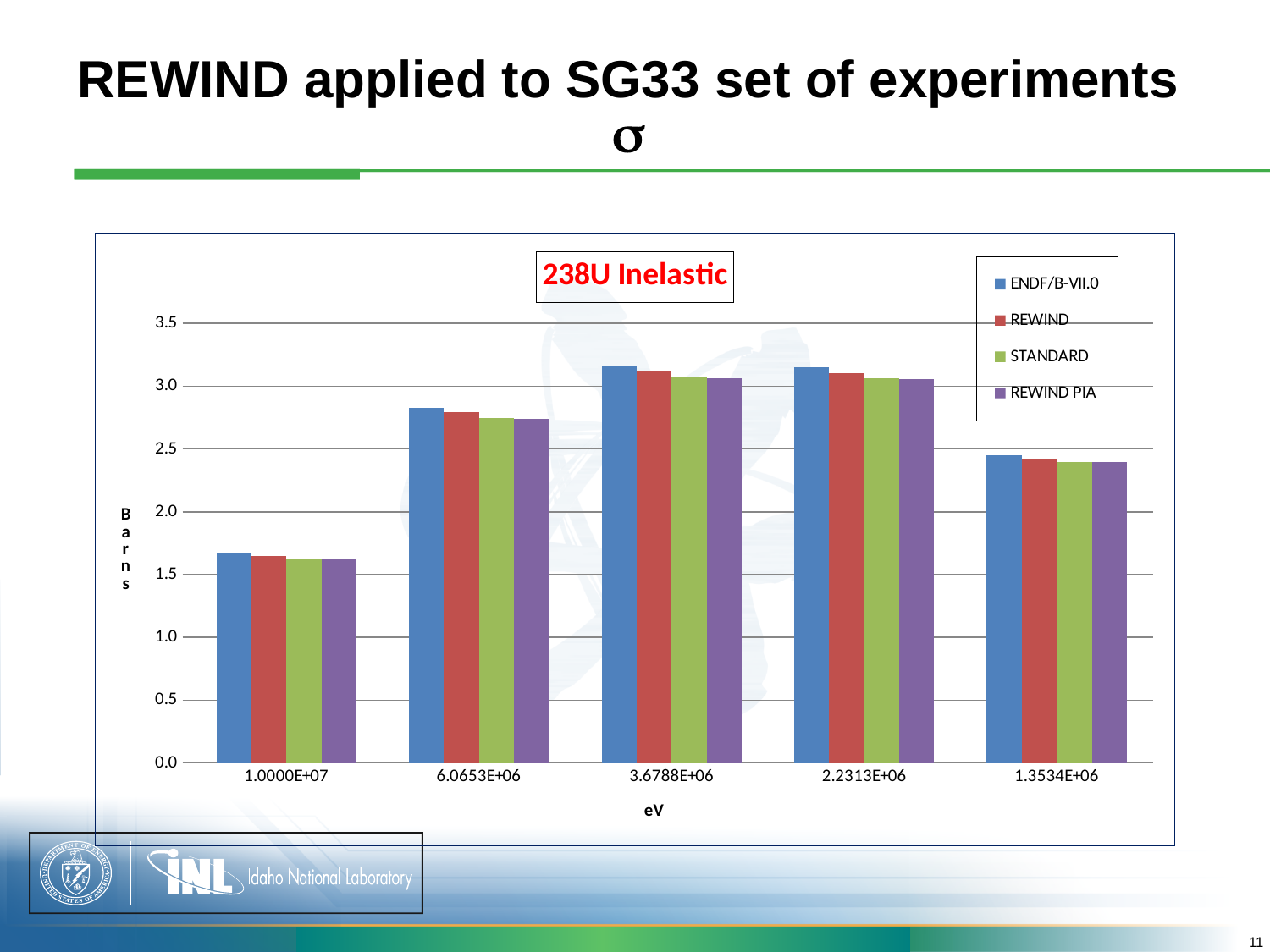
What is the label of the y axis? Barns Is the REWIND PIA value at 1.3534E+06 greater or less than 2.5? less How many series does the legend list? 4 How many energy categories are shown on the x axis? 5 What kind of chart is shown on the slide? bar chart Which energy category has the lowest values across all series? 1.0000E+07 Is the ENDF/B-VII.0 value larger at 6.0653E+06 or at 1.3534E+06? 6.0653E+06 Is the ENDF/B-VII.0 value at 1.0000E+07 greater or less than 1.5? greater Do the values rise or fall from the 2.2313E+06 category to the 1.3534E+06 category? fall What is the title of the chart? 238U Inelastic Is the STANDARD value at 6.0653E+06 greater or less than 2.5? greater